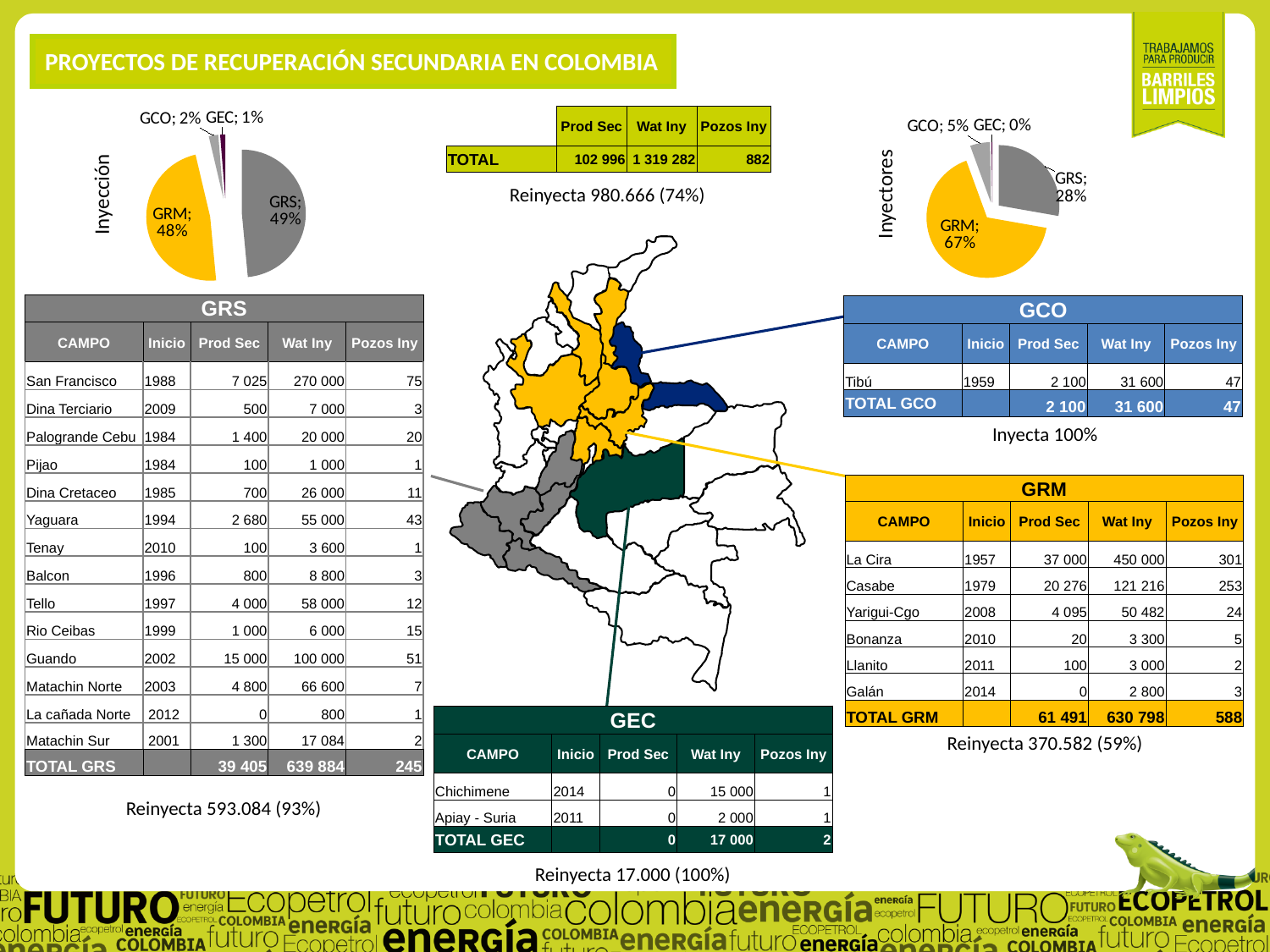
In the left pie chart labelled Inyección, how many slices are there? 4 In the left pie chart labelled Inyección, what share does GRM have? 48% What type of chart is used for Inyección and Inyectores on the slide? Pie chart In the left pie chart labelled Inyección, which category has the smallest share? GEC In the right pie chart labelled Inyectores, what share does GEC have? 0% In the right pie chart labelled Inyectores, which category has the largest share? GRM In the right pie chart labelled Inyectores, what share does GRM have? 67% In the right pie chart labelled Inyectores, which is larger, the share for GRM or the share for GCO? GRM In the left pie chart labelled Inyección, what share does GCO have? 2% In the left pie chart labelled Inyección, what share does GRS have? 49% In the right pie chart labelled Inyectores, what share does GRS have? 28% In the right pie chart labelled Inyectores, what is the difference between the GRM share and the GRS share? 39%